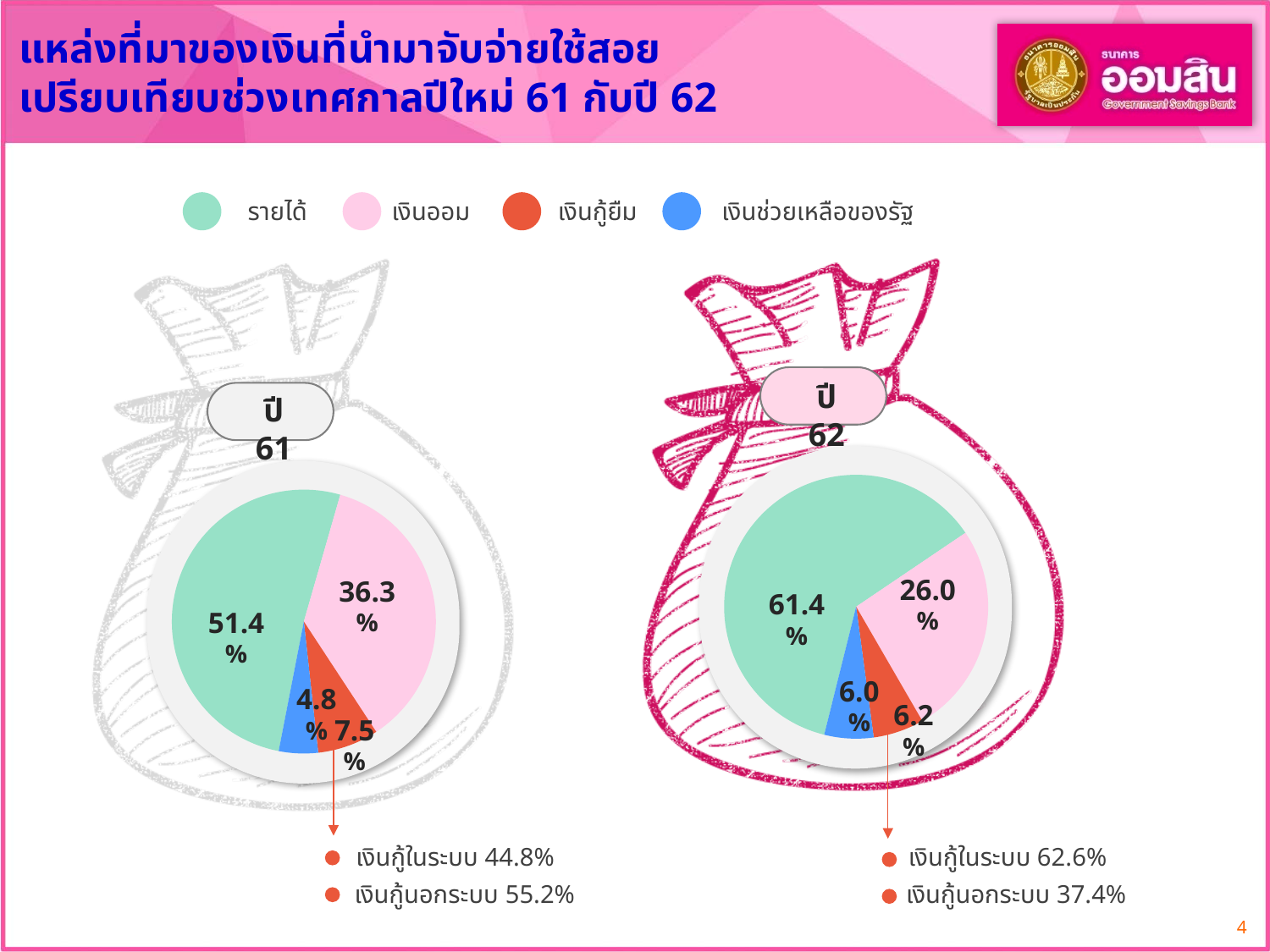
How many categories does the legend list? 4 In the ปี 62 pie chart, which category has the largest share? รายได้ How many slices does the ปี 61 pie chart have? 4 In the ปี 61 pie chart, what share is เงินช่วยเหลือของรัฐ? 4.8% Which colour represents เงินกู้ยืม in the legend? Red In the ปี 62 pie chart, what share is เงินออม? 26.0% In the ปี 61 pie chart, what share is รายได้? 51.4% What type of chart is used for ปี 61 and ปี 62? Pie chart What is the difference between the รายได้ share in the ปี 62 pie chart and the รายได้ share in the ปี 61 pie chart? 10.0% In the ปี 61 pie chart, which category has the smallest share? เงินช่วยเหลือของรัฐ Which is larger: the เงินออม share in the ปี 61 pie chart or the เงินออม share in the ปี 62 pie chart? ปี 61 In the ปี 62 pie chart, what share is เงินกู้ยืม? 6.2%